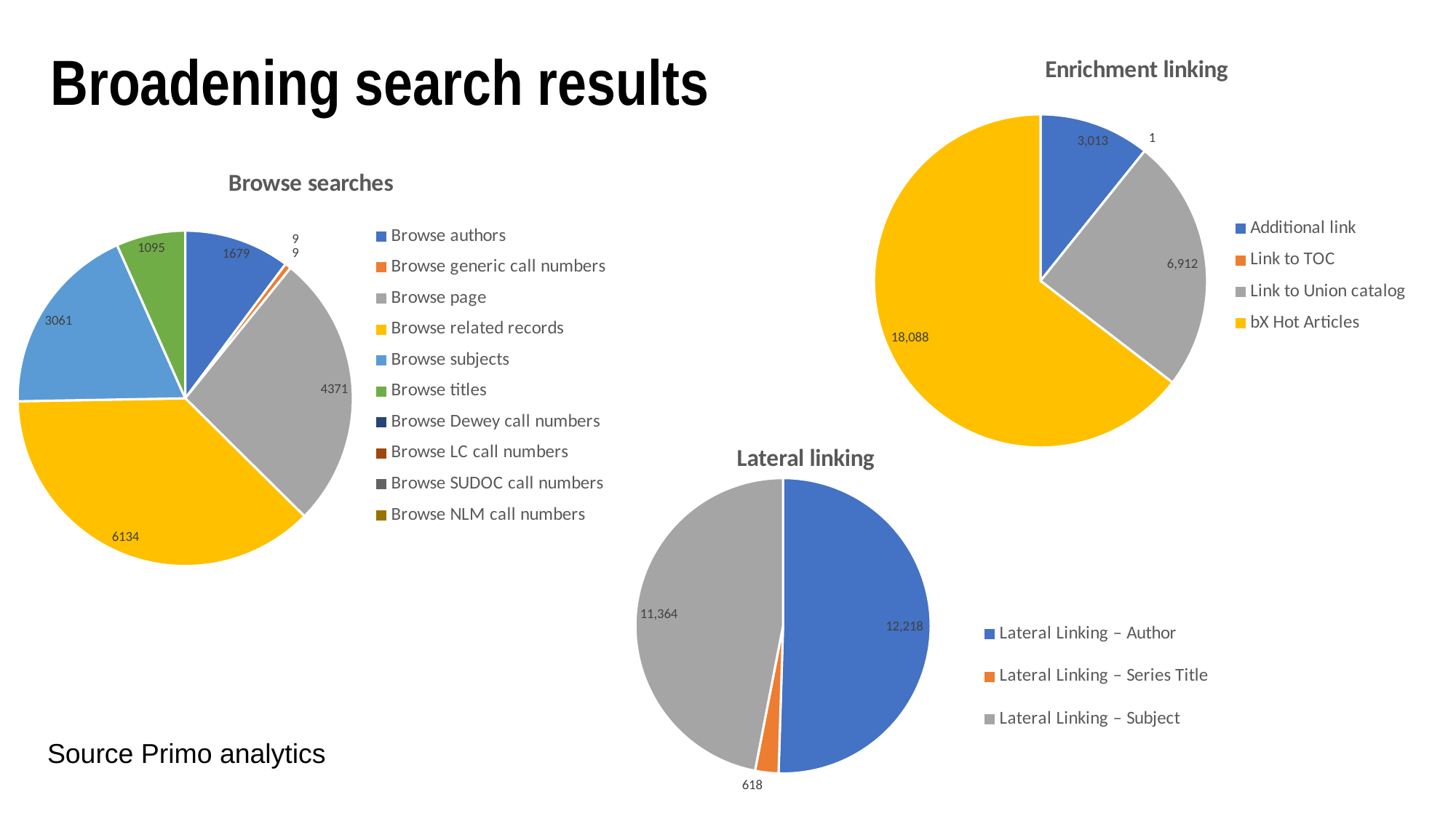
In the Enrichment linking chart, what is the value for bX Hot Articles? 18,088 In the Enrichment linking chart, which category has the smallest value? Link to TOC In the Lateral linking chart, what is the value for Lateral Linking – Series Title? 618 In the Browse searches chart, what is the value for Browse subjects? 3061 In the Browse searches chart, which category has the largest slice? Browse related records In the Enrichment linking chart, what is the value for Link to Union catalog? 6,912 How many entries does the legend of the Lateral linking chart list? 3 In the Lateral linking chart, which is larger: Lateral Linking – Author or Lateral Linking – Subject? Lateral Linking – Author In the Enrichment linking chart, what is the difference between bX Hot Articles and Link to Union catalog? 11,176 What type of chart is the Enrichment linking chart? Pie chart How many entries does the legend of the Browse searches chart list? 10 In the Browse searches chart, what is the difference between Browse related records and Browse page? 1763